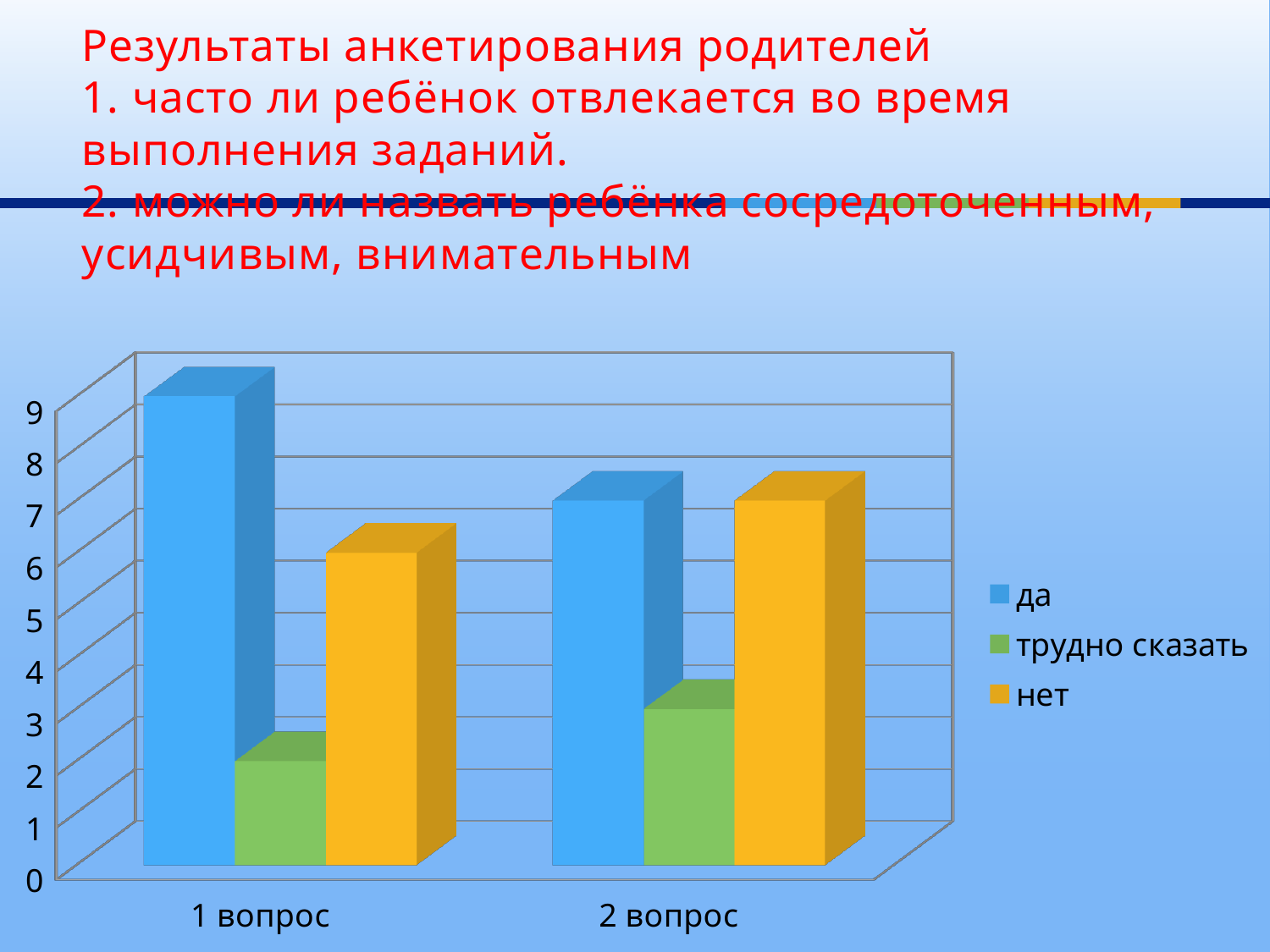
What kind of chart is shown on the slide? bar chart Is the value for "да" in "2 вопрос" greater or less than 5? greater Is the value for "нет" in "1 вопрос" greater or less than 5? greater Which series has the highest value in "1 вопрос"? да Which colour represents the "нет" series in the chart legend? yellow Which series has the lowest value in "2 вопрос"? трудно сказать How many series does the chart legend list? 3 How many categories are shown on the x axis of the chart? 2 Is the value for "трудно сказать" in "1 вопрос" greater or less than 4? less In "1 вопрос", which is larger: the value for "да" or the value for "нет"? да